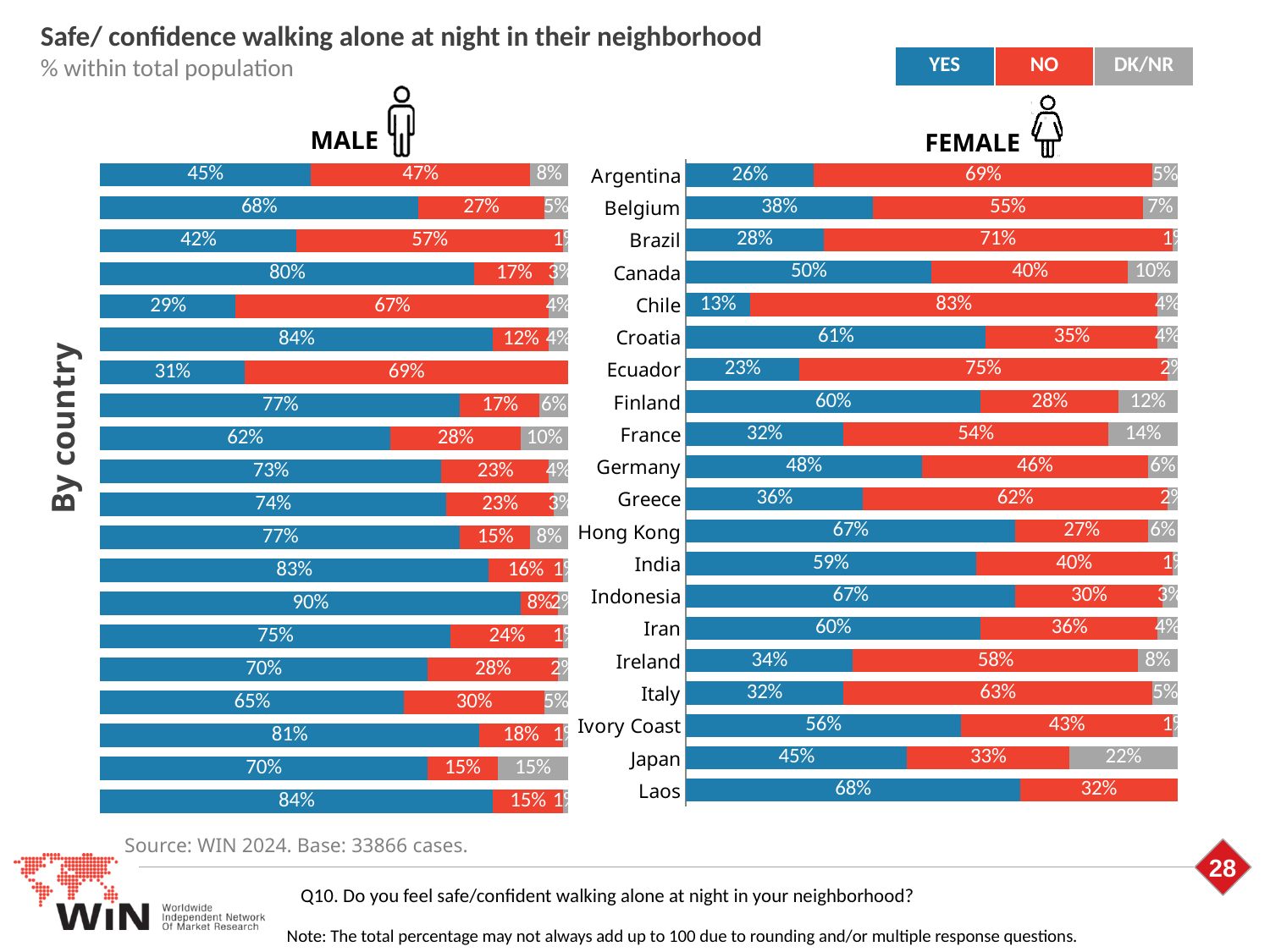
How many response categories does the legend list? 3 What type of chart is used to show the MALE and FEMALE results? Stacked bar chart In the FEMALE chart, what percentage of women in Chile answered NO? 83% In the FEMALE chart, which country has the lowest YES percentage? Chile What is the difference between the YES percentage for men and for women in Argentina? 19 percentage points In the FEMALE chart, which country has the highest NO percentage? Chile In the MALE chart, which country has the highest YES percentage? Indonesia In the MALE chart, what percentage of men in Canada answered YES? 80% In the FEMALE chart, what is the DK/NR value for Japan? 22% In the MALE chart, is the YES percentage higher for Belgium or for Italy? Belgium In the FEMALE chart, what is the difference between the YES and NO percentages for Germany? 2 percentage points How many countries are listed in the charts? 20